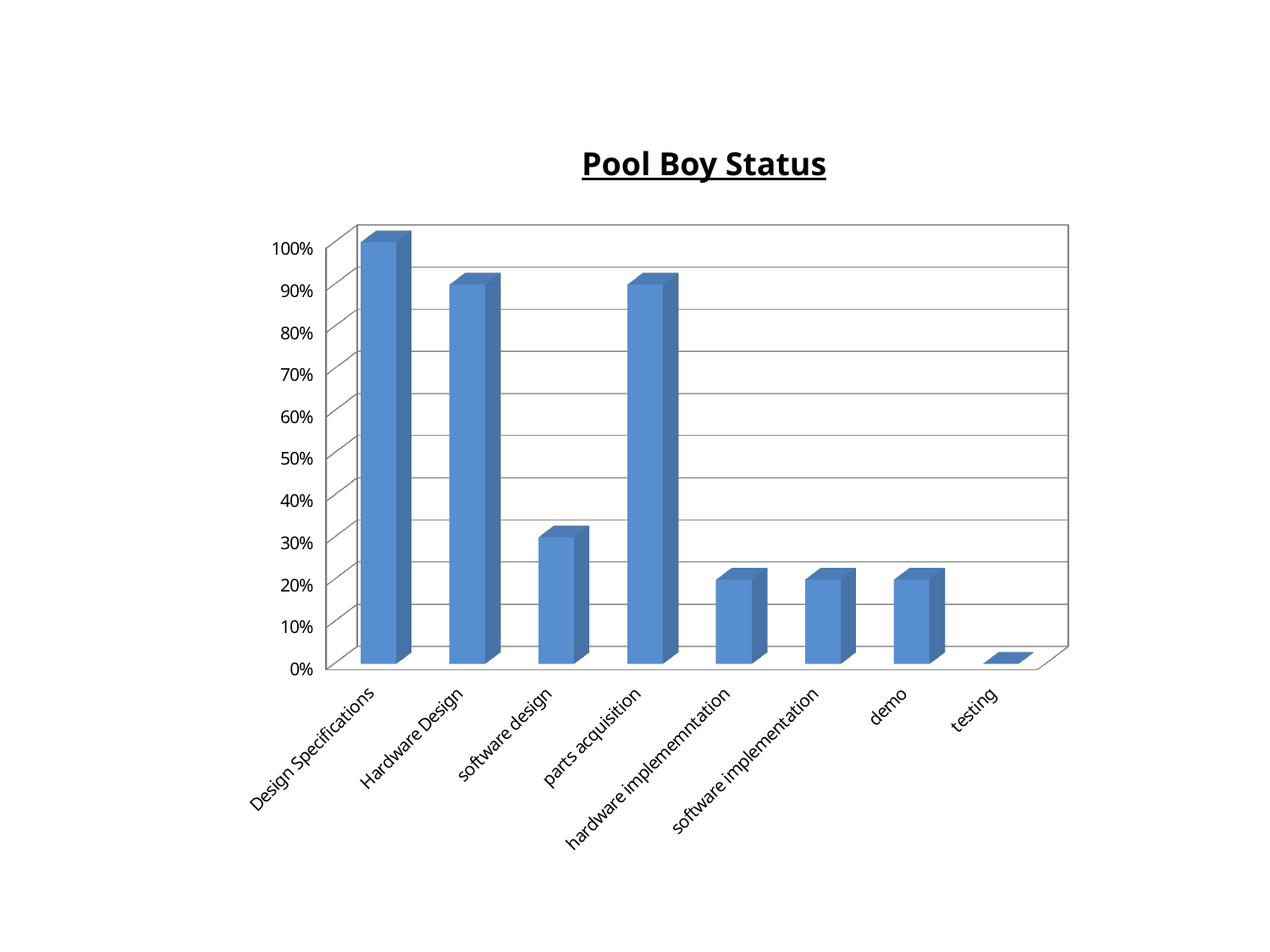
Is the value for software design greater or less than 50%? less Is the value for parts acquisition greater or less than 80%? greater What is the value for Design Specifications? 100% What kind of chart is shown on the slide? bar chart Is the value for demo greater or less than 30%? less What is the title of the chart? Pool Boy Status Which category has the lowest value in the chart? testing Which is larger, the value for Hardware Design or the value for software design? Hardware Design Which category has the highest value in the chart? Design Specifications How many categories are shown on the x axis of the chart? 8 Which is larger, the value for software design or the value for hardware implememntation? software design What is the value for testing? 0%